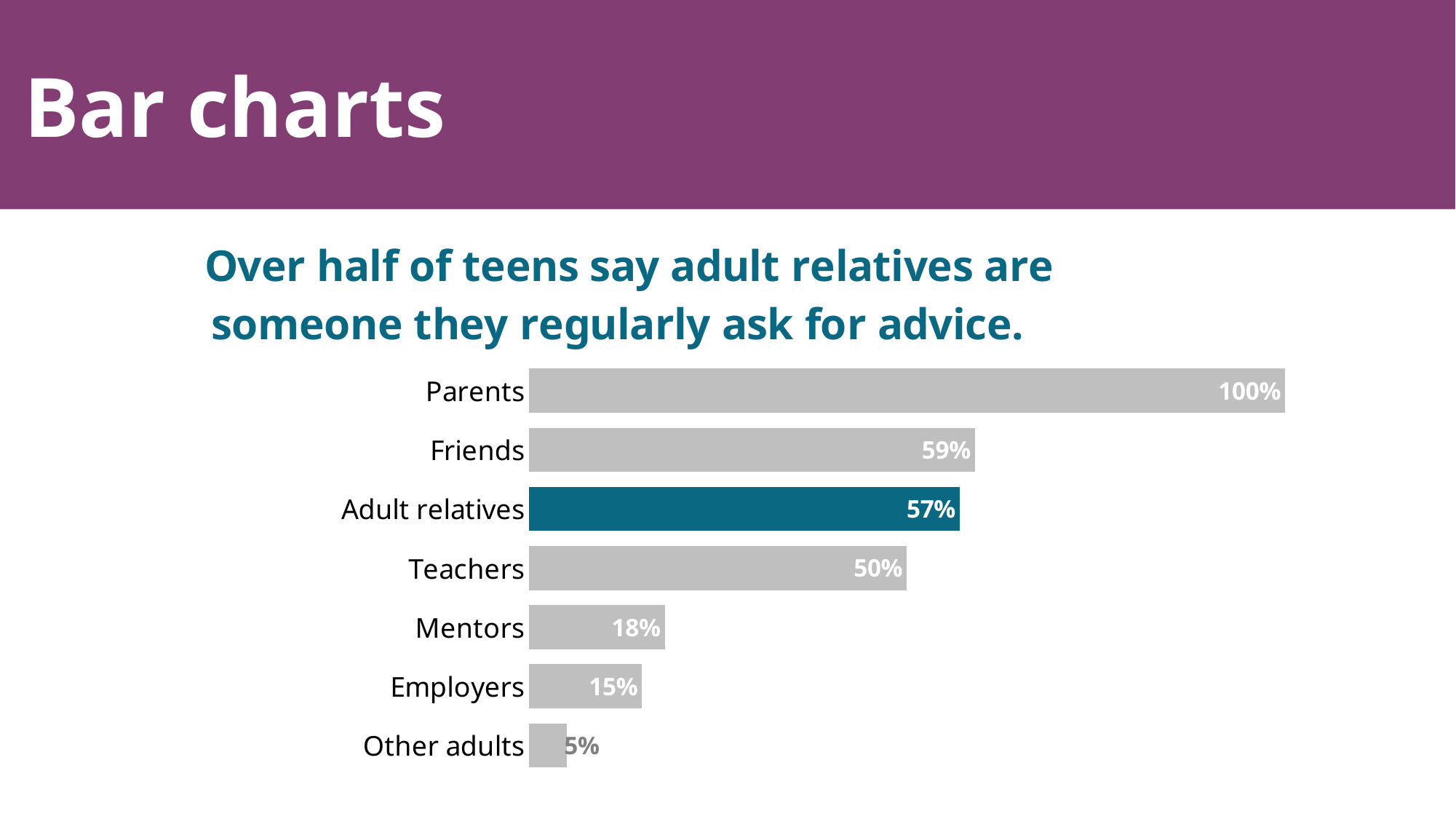
Which bar is highlighted in a different colour from the others? Adult relatives Which category has the lowest value? Other adults What percentage of teens say they regularly ask adult relatives for advice? 57% What is the value shown for Employers? 15% How many categories are shown in the chart? 7 What is the value shown for Mentors? 18% What is the difference between the values for Parents and Teachers? 50% Which is larger, the value for Mentors or the value for Employers? Mentors What is the difference between the values for Friends and Adult relatives? 2% What is the value shown for Teachers? 50% What kind of chart is shown on the slide? Bar chart Which category has the highest value? Parents